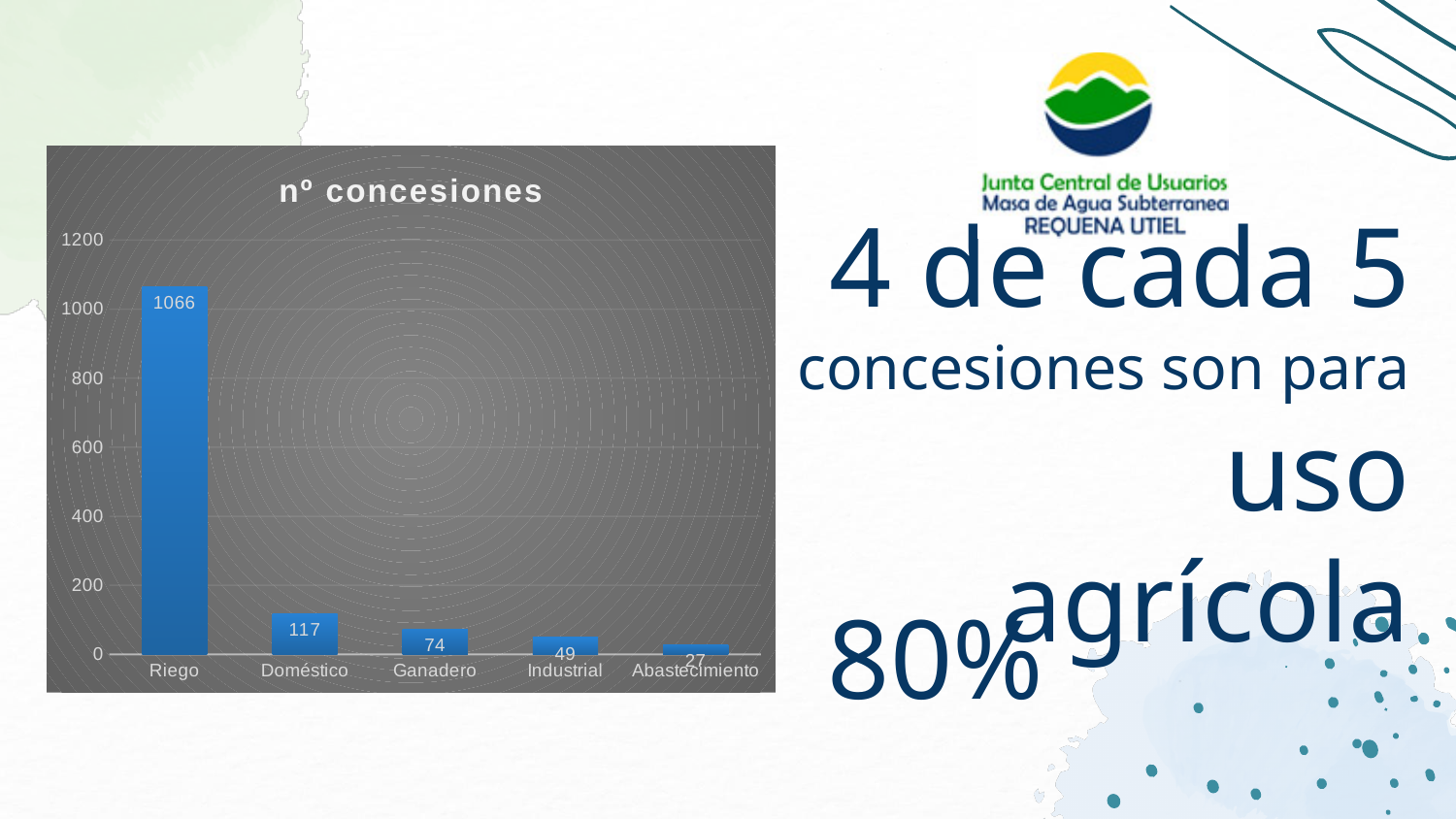
Is the value for Riego greater or less than 1000? greater Which has more concessions, Ganadero or Industrial? Ganadero What is the number of concessions for Ganadero? 74 What is the title of the chart? nº concesiones What is the difference between the number of concessions for Riego and Doméstico? 949 Which category has the lowest number of concessions? Abastecimiento Which category has the highest number of concessions? Riego What is the number of concessions for Doméstico? 117 How many categories are shown on the x axis of the chart? 5 What kind of chart is shown on the slide? Bar chart What is the number of concessions for Riego? 1066 What is the number of concessions for Industrial? 49